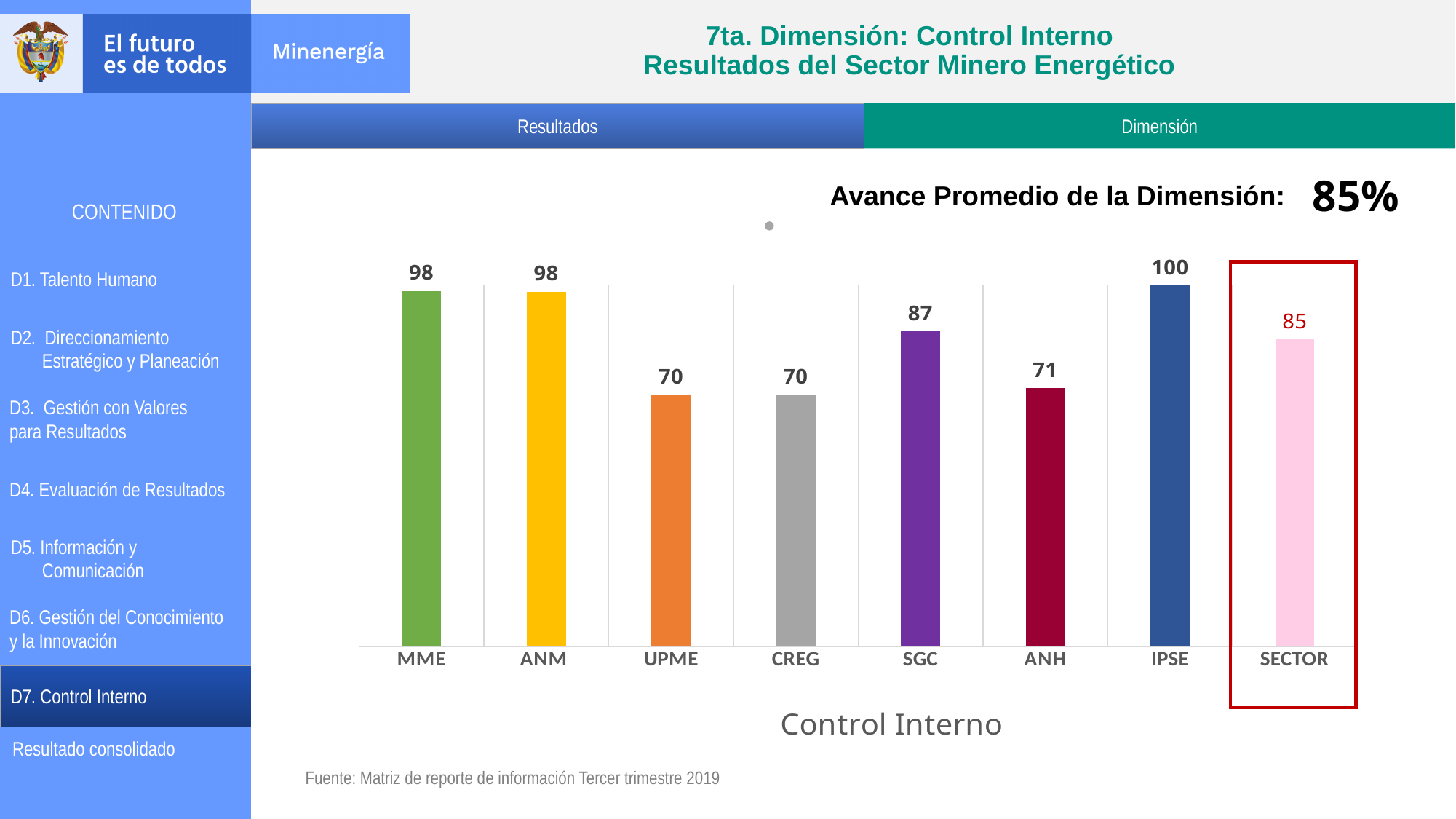
How many categories are shown in the Control Interno chart? 8 Which is larger in the Control Interno chart, the value for SECTOR or the value for CREG? SECTOR What kind of chart is the Control Interno chart? Bar chart What is the value for SGC in the Control Interno chart? 87 What is the title shown below the chart? Control Interno Which category has the highest value in the Control Interno chart? IPSE What is the 'Avance Promedio de la Dimensión' value shown above the chart? 85% What is the value for SECTOR in the Control Interno chart? 85 What is the difference between the values for IPSE and ANH in the Control Interno chart? 29 What is the difference between the values for MME and UPME in the Control Interno chart? 28 What is the value for IPSE in the Control Interno chart? 100 Which is larger in the Control Interno chart, the value for SGC or the value for ANH? SGC